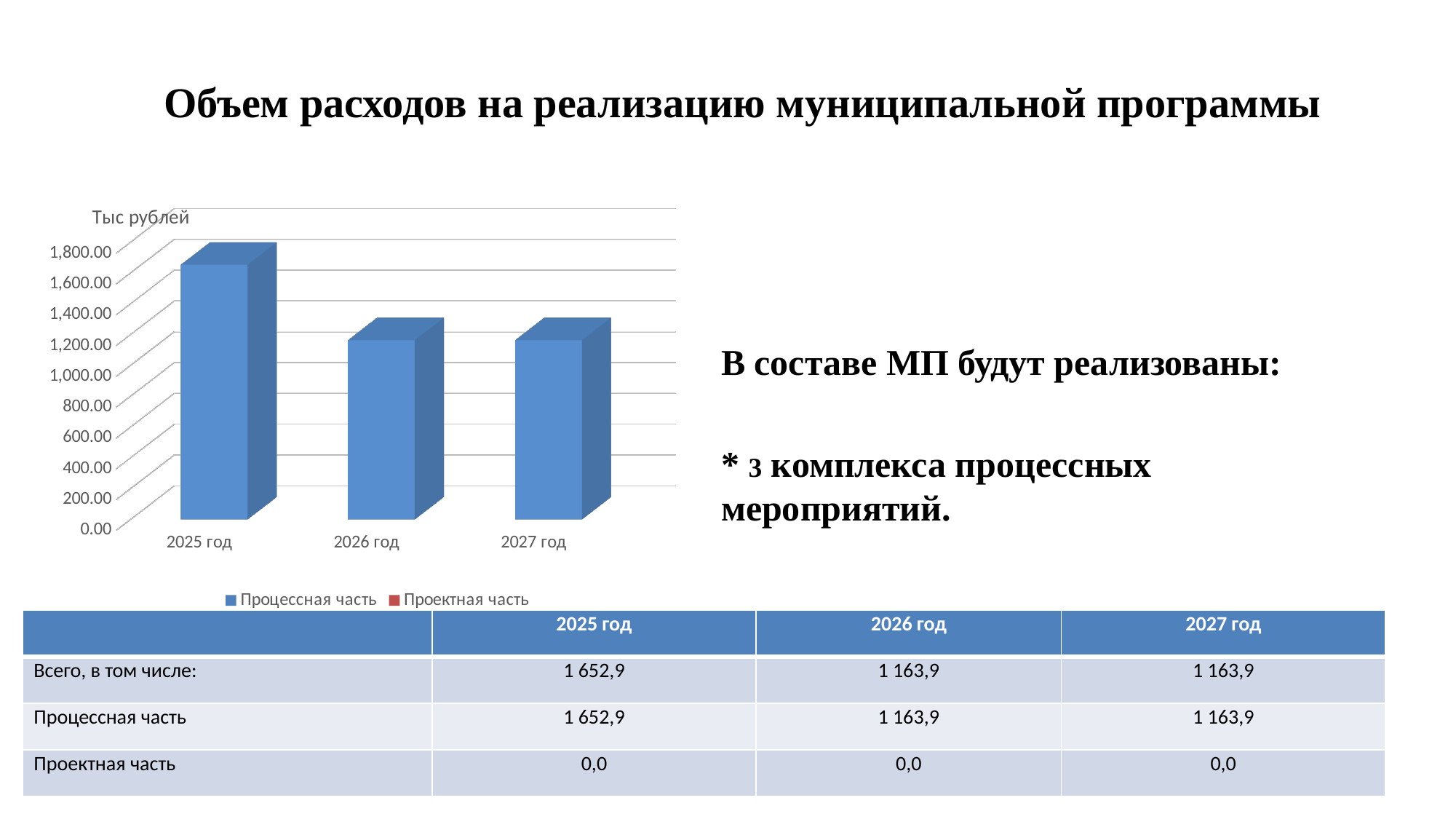
Is the value for 2026 год greater or less than 1,400.00? less How many series does the chart legend list? 2 Is the value for 2025 год greater or less than 1,400.00? greater How many years (categories) are shown on the x axis of the chart? 3 According to the table under the chart, what is the value of Процессная часть for 2025 год? 1 652,9 Is the value for 2027 год greater or less than 1,000.00? greater Do the bar values rise or fall from 2025 год to 2027 год? fall Which year has the highest bar in the chart? 2025 год What unit label is shown at the top of the chart's vertical axis? Тыс рублей What kind of chart is shown on the slide? bar chart Which is larger, the bar for 2025 год or the bar for 2026 год? 2025 год According to the table under the chart, what is the value of Проектная часть for 2027 год? 0,0